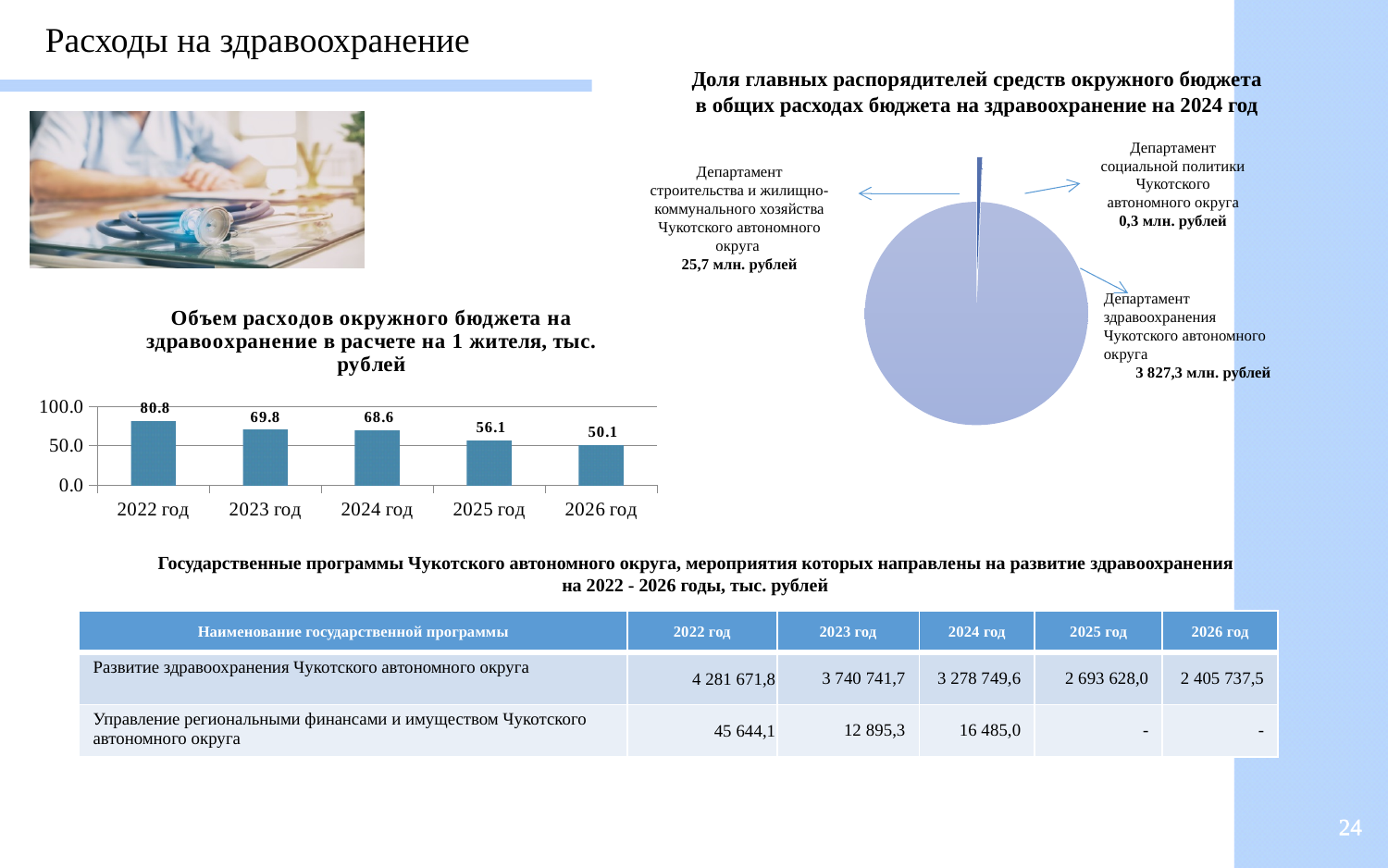
On the bar chart 'Объем расходов окружного бюджета на здравоохранение в расчете на 1 жителя, тыс. рублей', which year has the highest value? 2022 год On the bar chart 'Объем расходов окружного бюджета на здравоохранение в расчете на 1 жителя, тыс. рублей', what is the value for 2025 год? 56.1 On the pie chart 'Доля главных распорядителей средств окружного бюджета в общих расходах бюджета на здравоохранение на 2024 год', which department has the smallest slice? Департамент социальной политики Чукотского автономного округа On the bar chart 'Объем расходов окружного бюджета на здравоохранение в расчете на 1 жителя, тыс. рублей', which is larger: the value for 2023 год or 2024 год? 2023 год On the bar chart 'Объем расходов окружного бюджета на здравоохранение в расчете на 1 жителя, тыс. рублей', what is the value for 2022 год? 80.8 On the bar chart 'Объем расходов окружного бюджета на здравоохранение в расчете на 1 жителя, тыс. рублей', how many years are shown? 5 On the bar chart 'Объем расходов окружного бюджета на здравоохранение в расчете на 1 жителя, тыс. рублей', what is the difference between the values for 2022 год and 2026 год? 30.7 On the pie chart 'Доля главных распорядителей средств окружного бюджета в общих расходах бюджета на здравоохранение на 2024 год', what is the value for Департамент строительства и жилищно-коммунального хозяйства Чукотского автономного округа? 25,7 млн. рублей On the bar chart 'Объем расходов окружного бюджета на здравоохранение в расчете на 1 жителя, тыс. рублей', do the values rise or fall from 2022 год to 2026 год? fall What kind of chart is the chart titled 'Объем расходов окружного бюджета на здравоохранение в расчете на 1 жителя, тыс. рублей'? bar chart On the pie chart 'Доля главных распорядителей средств окружного бюджета в общих расходах бюджета на здравоохранение на 2024 год', what is the value for Департамент здравоохранения Чукотского автономного округа? 3 827,3 млн. рублей On the bar chart 'Объем расходов окружного бюджета на здравоохранение в расчете на 1 жителя, тыс. рублей', which year has the lowest value? 2026 год